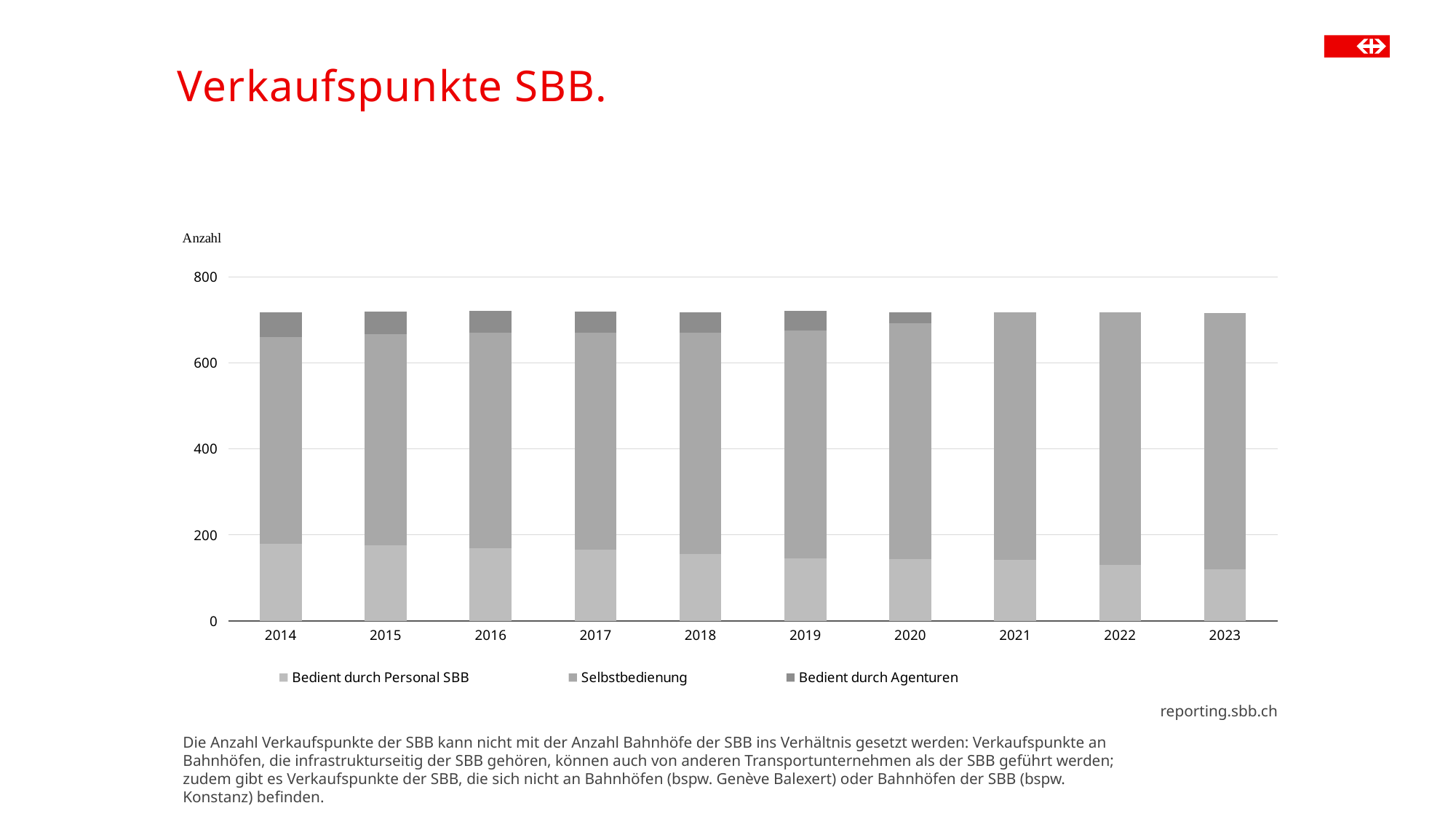
Which year has the larger value for Bedient durch Personal SBB, 2014 or 2023? 2014 Is the value for Bedient durch Personal SBB in 2023 greater or less than 200? less How many years are shown on the x axis of the chart? 10 What is the title of the slide containing the chart? Verkaufspunkte SBB. Is the total height of the stacked bar for 2023 greater or less than 600? greater What label is shown on the vertical axis of the chart? Anzahl How many series does the legend of the chart list? 3 Does the value for Bedient durch Personal SBB rise or fall from 2014 to 2023? fall Is the total height of the stacked bar for 2014 greater or less than 800? less What kind of chart is shown on the slide? stacked bar chart